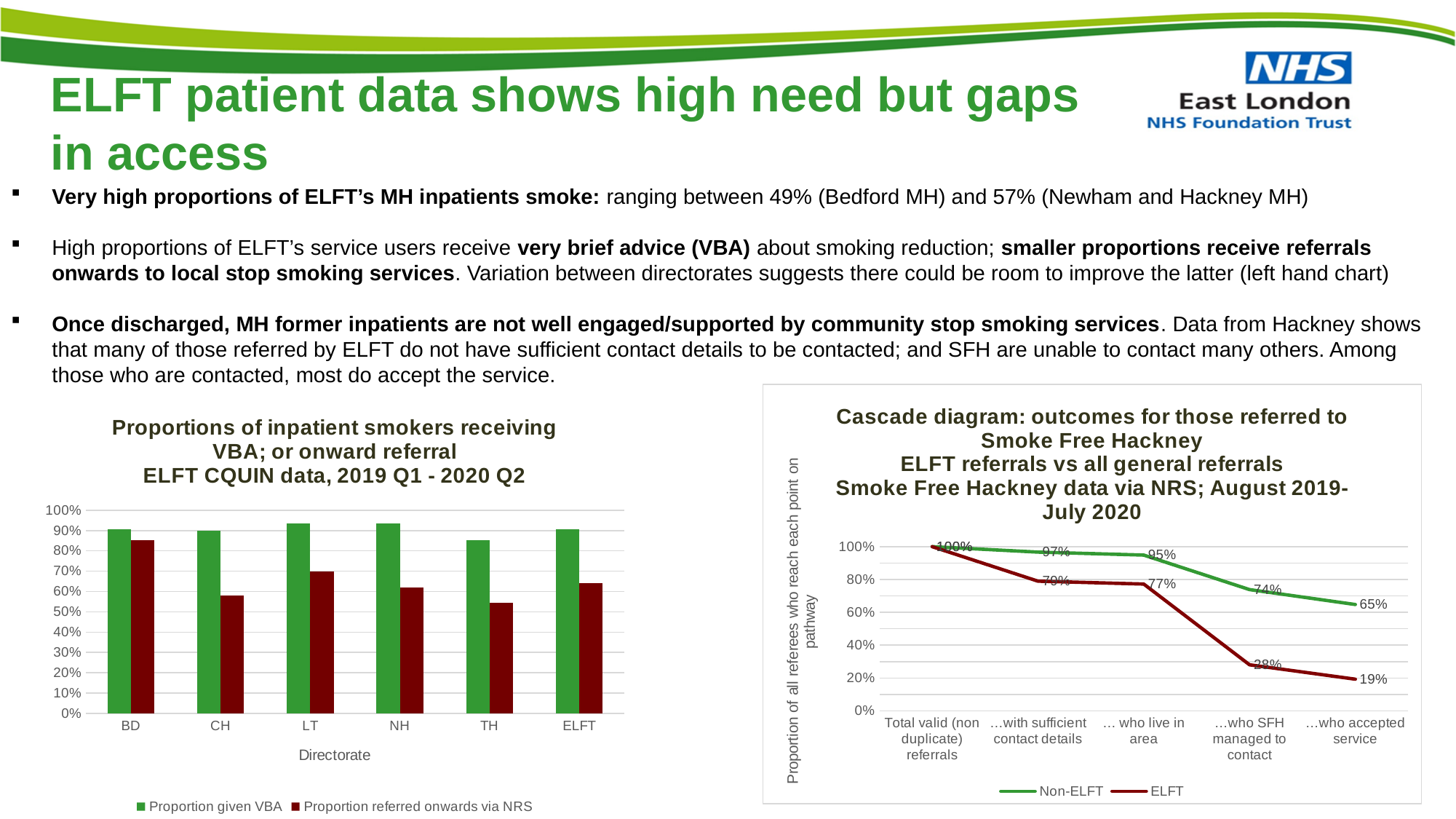
What type of chart is the left chart, 'Proportions of inpatient smokers receiving VBA; or onward referral'? bar chart In the right cascade chart, what is the difference between the Non-ELFT and ELFT percentages at the '…who SFH managed to contact' stage? 46% In the right cascade chart, do the ELFT values rise or fall along the pathway from left to right? fall In the right cascade chart, what percentage of ELFT referees had sufficient contact details? 79% In the left chart, how many series does the legend list? 2 In the left chart, how many directorates are shown on the x axis? 6 In the left chart, is the proportion referred onwards via NRS for CH greater or less than 50%? greater In the right cascade chart, what percentage of Non-ELFT referees accepted the service? 65% In the left chart, which is larger: the proportion referred onwards via NRS for BD or for CH? BD In the left chart, which directorate has the highest proportion referred onwards via NRS? BD In the left chart, is the proportion referred onwards via NRS for TH greater or less than 60%? less What type of chart is the right chart, the cascade diagram for those referred to Smoke Free Hackney? line chart